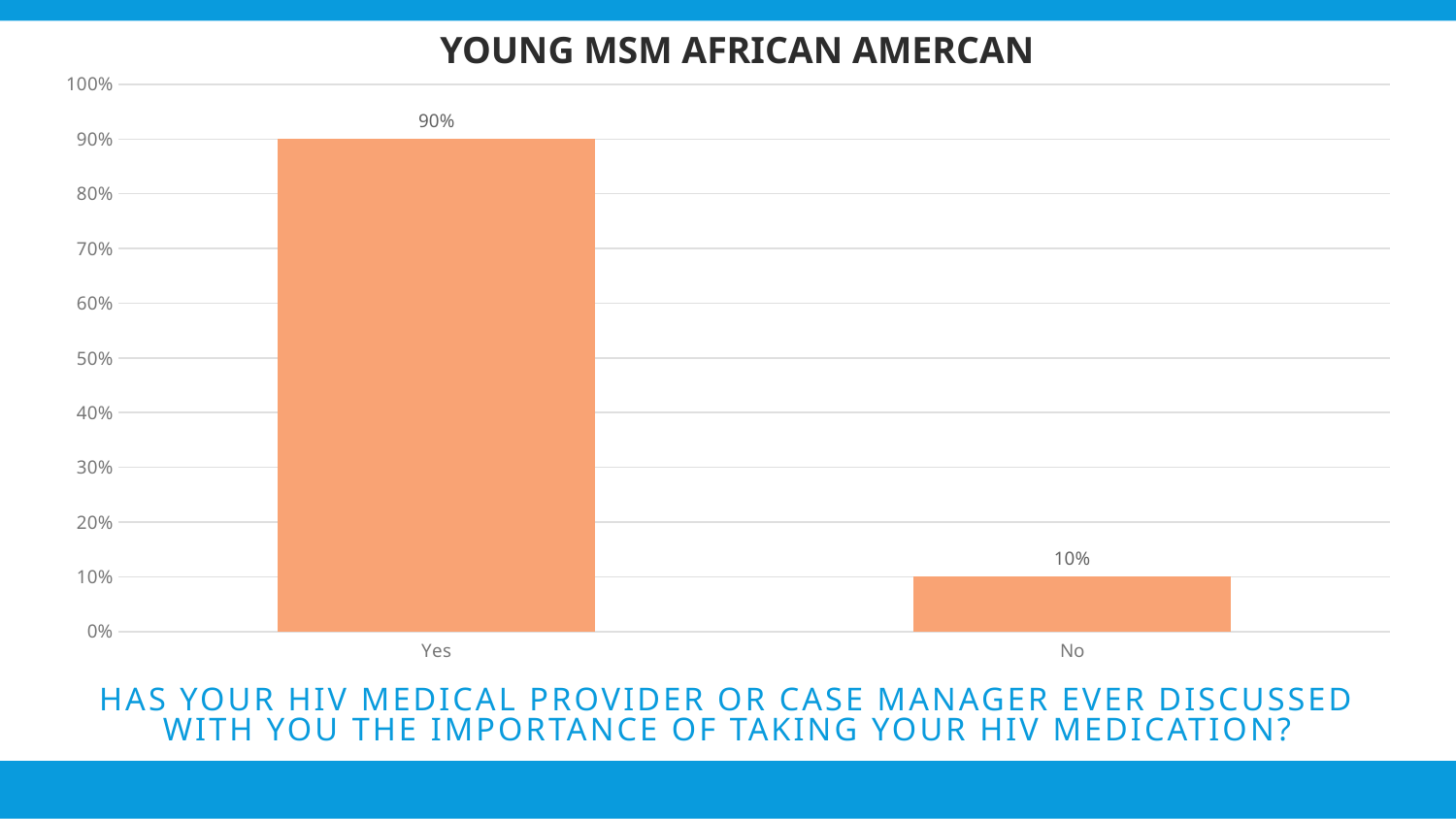
What is the value for Yes? 90% What is the value for No? 10% Which is larger, the value for Yes or the value for No? Yes What is the highest value shown on the y axis? 100% Which category has the lowest value? No Is the value for Yes greater or less than 50%? greater How many categories are shown on the x axis? 2 What is the difference between the values for Yes and No? 80% What is the title of the chart? YOUNG MSM AFRICAN AMERCAN What kind of chart is shown on the slide? bar chart Is the value for No greater or less than 20%? less Which category has the highest value? Yes